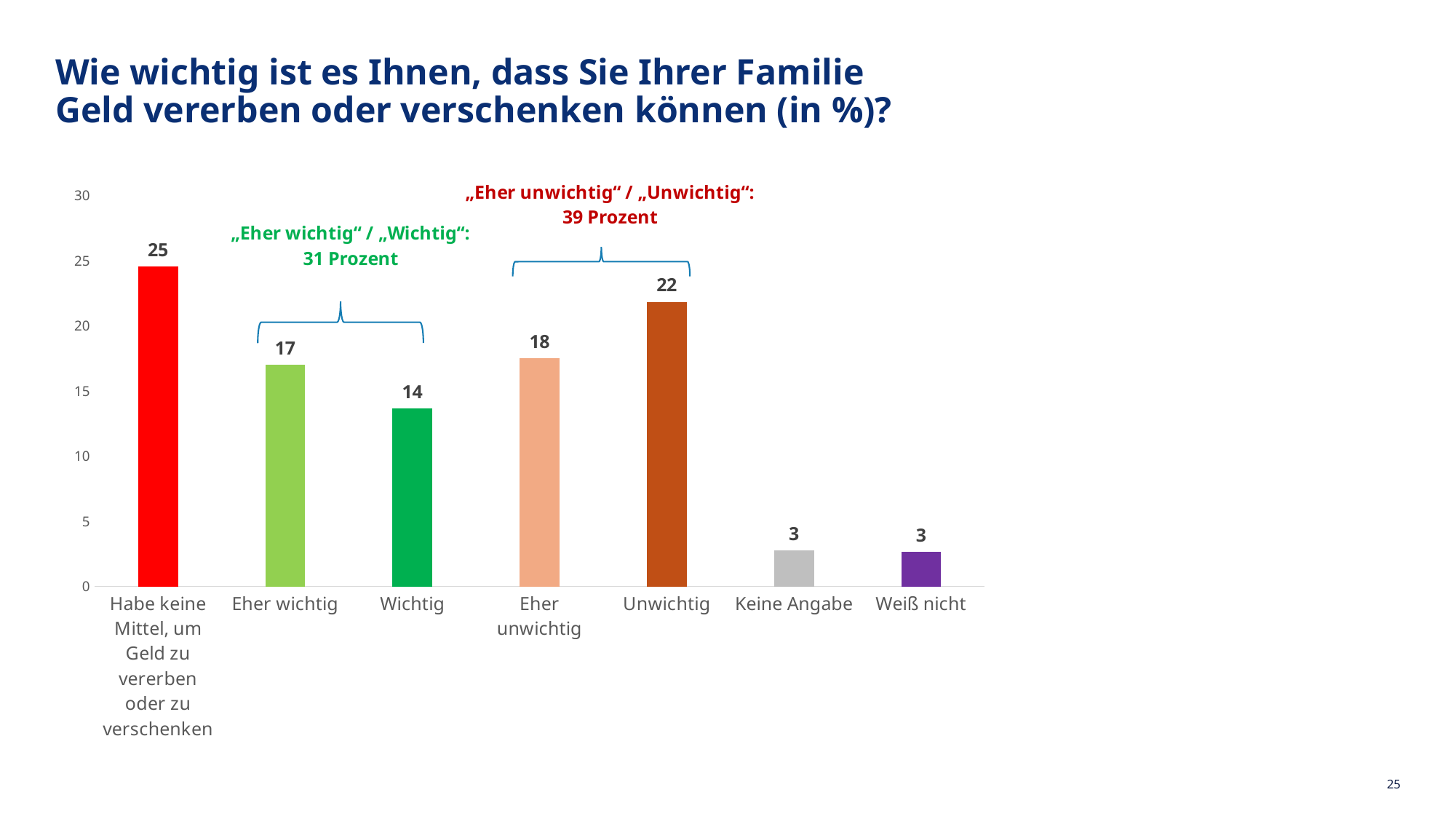
How many categories are shown on the x axis? 7 What is the value for "Unwichtig"? 22 What is the value for "Habe keine Mittel, um Geld zu vererben oder zu verschenken"? 25 Which category has the highest value? Habe keine Mittel, um Geld zu vererben oder zu verschenken What kind of chart is shown on the slide? Bar chart According to the annotation, what percentage answered "Eher unwichtig" or "Unwichtig"? 39 Prozent What colour is the bar for "Weiß nicht"? Purple What is the value for "Eher wichtig"? 17 What is the difference between the values for "Unwichtig" and "Wichtig"? 8 What is the value for "Keine Angabe"? 3 What is the combined value for "Eher wichtig" and "Wichtig"? 31 Which is larger, the value for "Eher unwichtig" or the value for "Eher wichtig"? Eher unwichtig